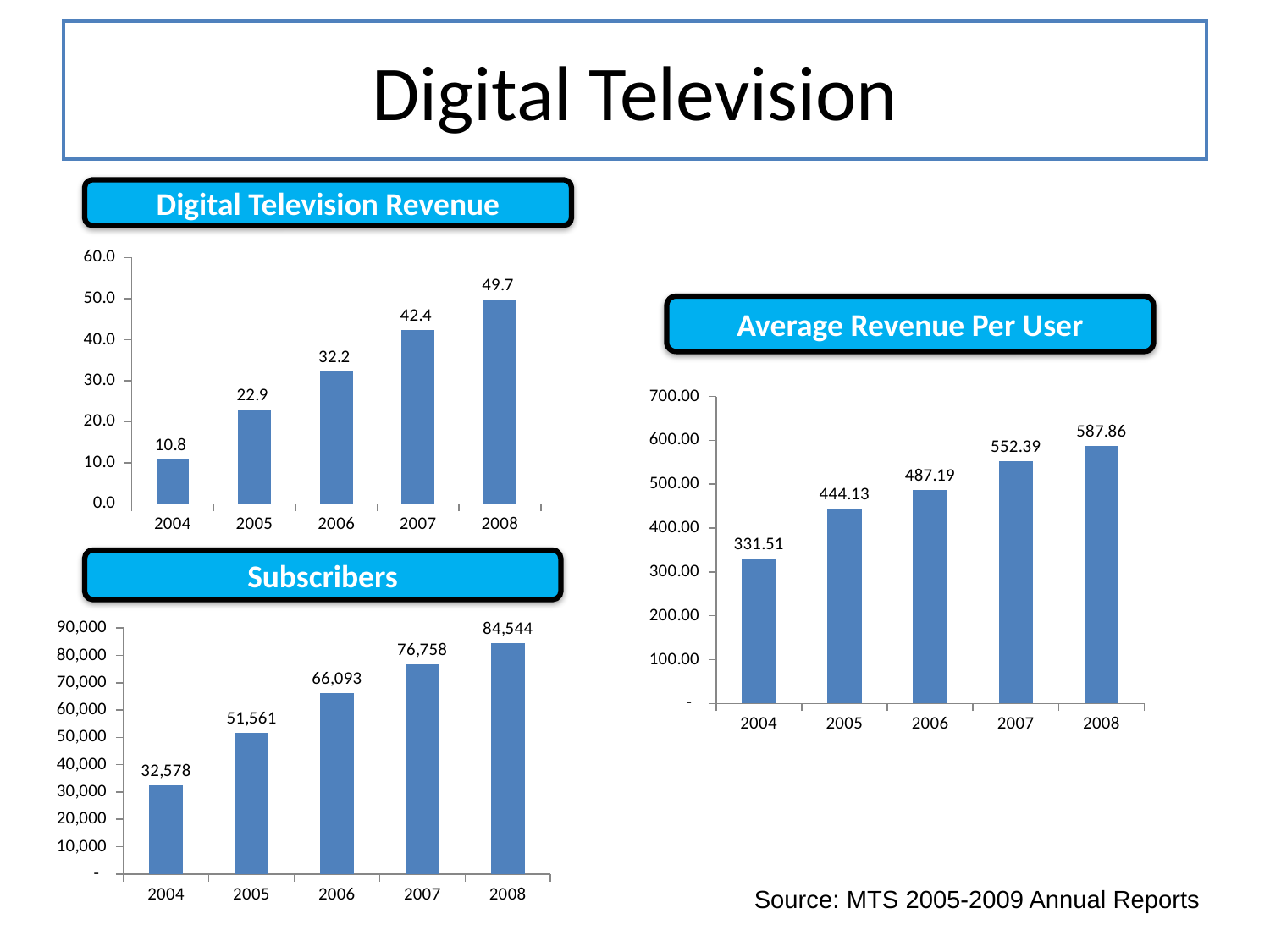
In the Average Revenue Per User chart, do the values rise or fall from 2004 to 2008? Rise In the Digital Television Revenue chart, which year has the lowest value? 2004 In the Subscribers chart, which year has the highest value? 2008 In the Digital Television Revenue chart, what is the difference between the 2008 and 2004 values? 38.9 What kind of chart is the Digital Television Revenue chart? Bar chart In the Digital Television Revenue chart, what is the value for 2006? 32.2 In the Average Revenue Per User chart, is the value for 2007 larger than the value for 2006? Yes In the Subscribers chart, what is the value for 2007? 76,758 In the Average Revenue Per User chart, what is the value for 2005? 444.13 In the Subscribers chart, what is the difference between the 2006 and 2005 values? 14,532 How many charts are on the slide? 3 How many years are shown in the Subscribers chart? 5